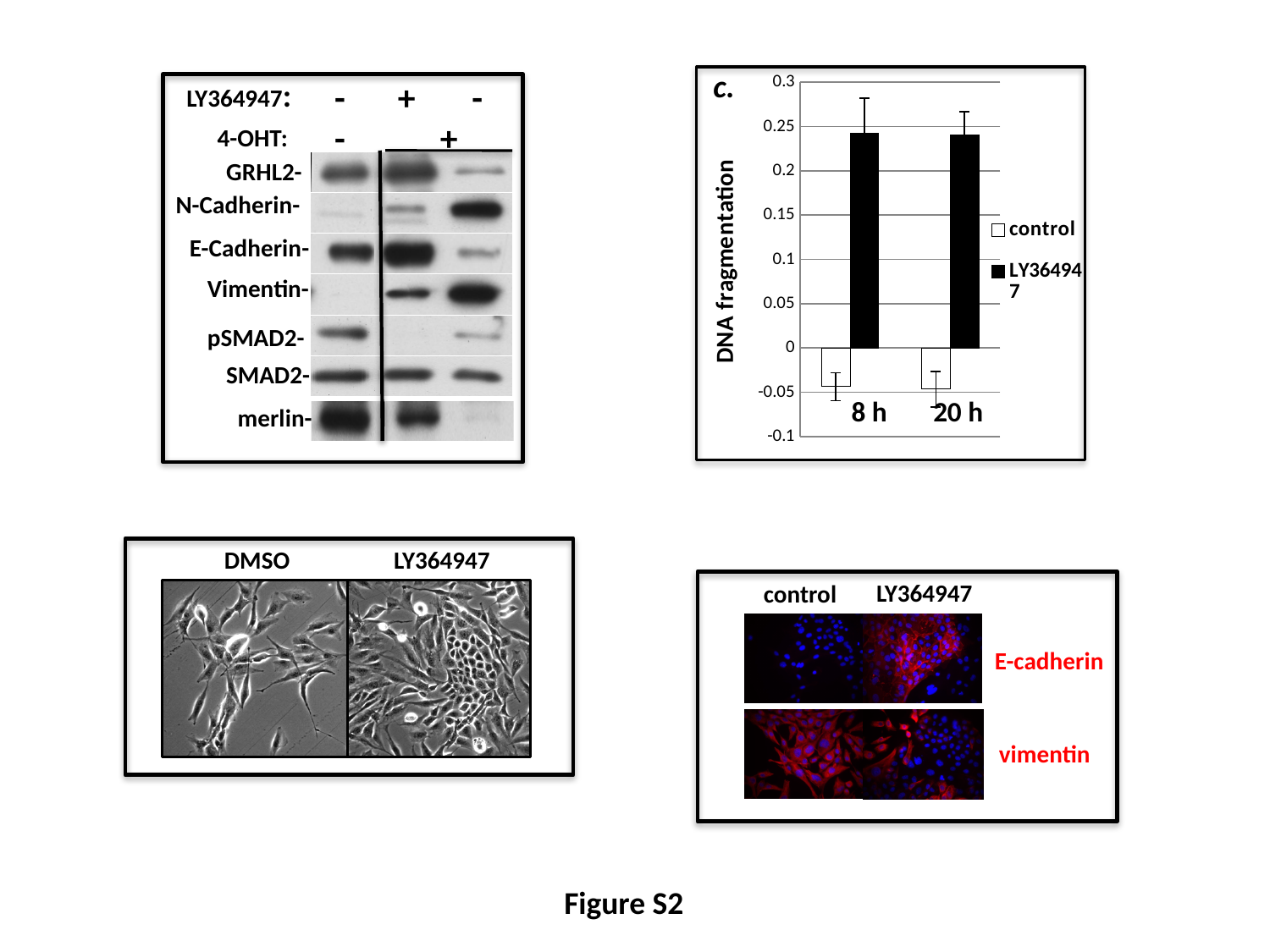
In the chart in panel c, is the control value at 8 h greater or less than 0? less In the chart in panel c, which series has the larger value at 8 h, control or LY364947? LY364947 What is the y-axis label of the chart in panel c? DNA fragmentation In the chart in panel c, which series has the lower value at 20 h? control How many series does the legend of the chart in panel c list? 2 How many time-point categories are shown on the x axis of the chart in panel c? 2 What are the two x-axis category labels in the chart in panel c? 8 h and 20 h In the chart in panel c, is the control value at 20 h greater or less than 0? less In the chart in panel c, is the LY364947 value at 20 h greater or less than 0.2? greater In the chart in panel c, which series is drawn with black bars? LY364947 What kind of chart is panel c? bar chart